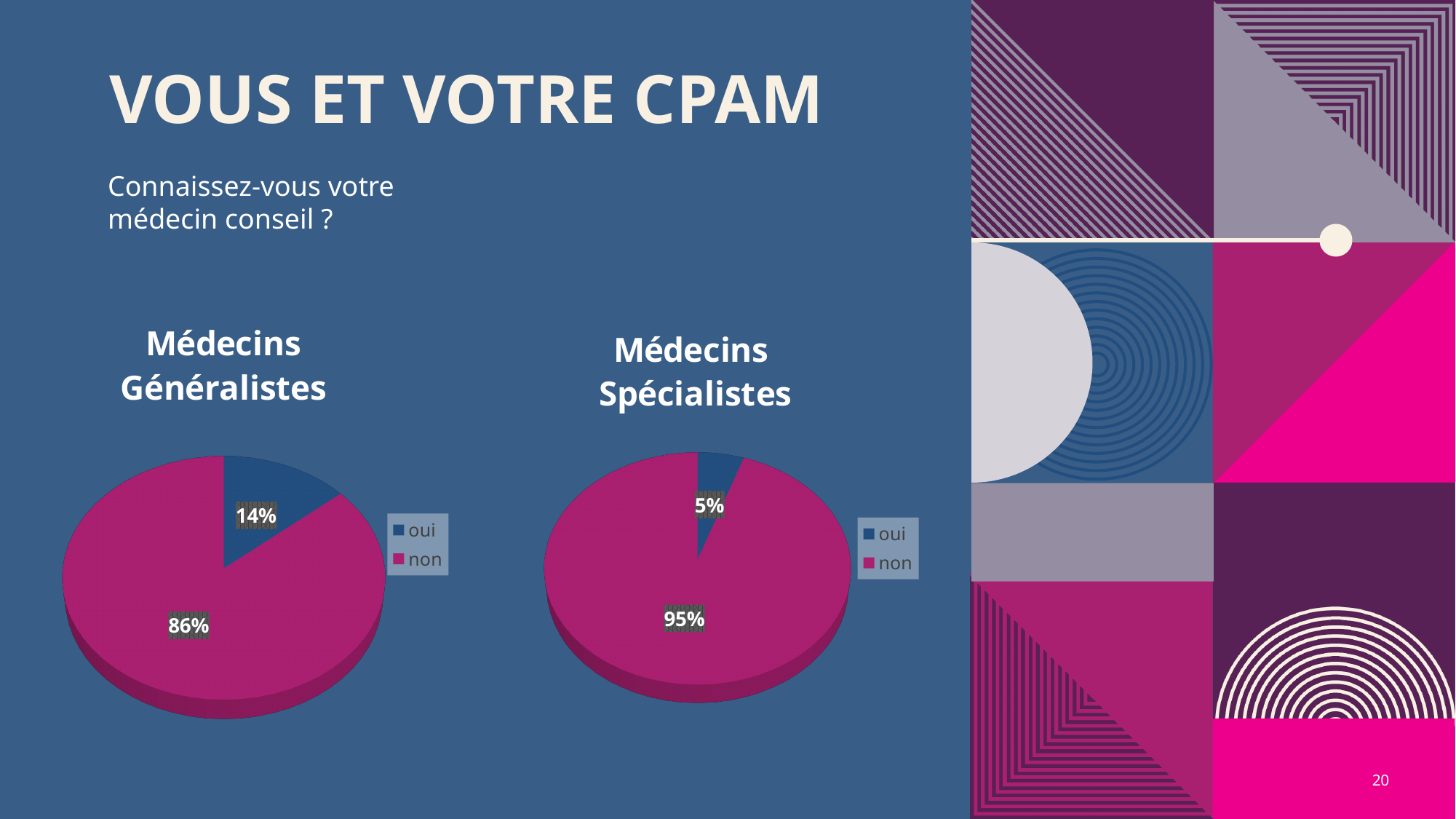
What kind of chart is the Médecins Spécialistes chart? Pie chart In the Médecins Spécialistes chart, what percentage answered "non"? 95% In the Médecins Généralistes chart, what percentage answered "non"? 86% In the Médecins Spécialistes chart, what percentage answered "oui"? 5% How many entries does the legend of the Médecins Spécialistes chart list? 2 In the Médecins Spécialistes chart, which slice is the smallest? oui In the Médecins Généralistes chart, what is the difference between the "non" and "oui" shares? 72% In the Médecins Généralistes chart, what percentage answered "oui"? 14% In the Médecins Généralistes chart, which slice is the largest? non Which chart has the larger "oui" share, Médecins Généralistes or Médecins Spécialistes? Médecins Généralistes How many slices does the Médecins Généralistes pie chart have? 2 In the Médecins Généralistes chart, what colour is the "non" slice? Magenta/pink